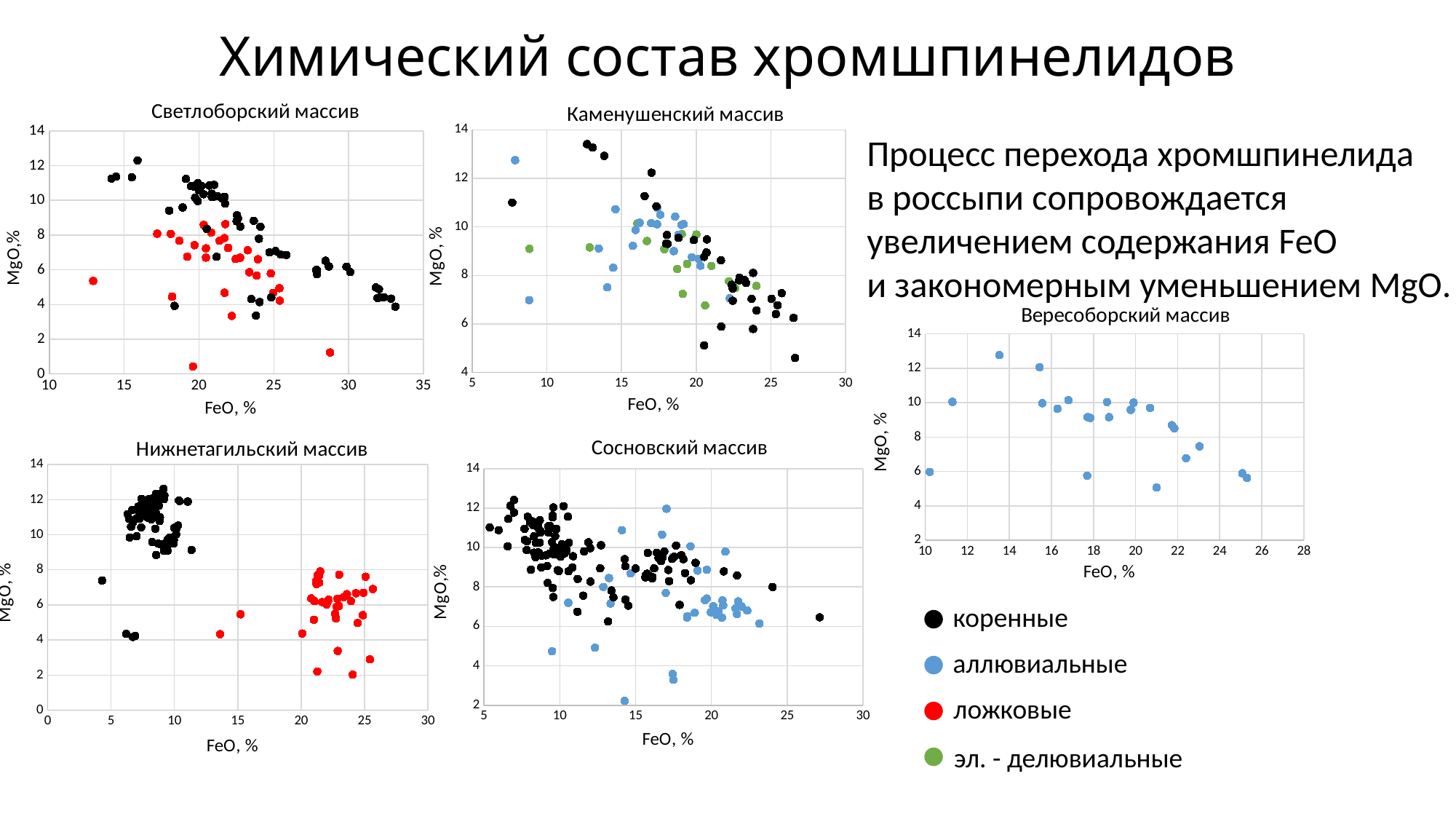
What kind of chart is 'Светлоборский массив'? scatter chart In the 'Сосновский массив' chart, do the black (коренные) points' MgO values rise or fall as FeO increases? fall In the 'Светлоборский массив' chart, is the MgO value of the lowest red point greater or less than 2? less In the 'Вересоборский массив' chart, do the MgO values rise or fall as FeO increases? fall In the 'Каменушенский массив' chart, do the MgO values rise or fall as FeO increases? fall In the 'Вересоборский массив' chart, is the highest MgO value greater or less than 12? greater In the 'Нижнетагильский массив' chart, are the FeO values of the black (коренные) points greater or less than 15? less How many categories does the legend on the slide list? 4 Which colour represents 'аллювиальные' in the legend? blue Which chart on the slide contains only blue points? Вересоборский массив